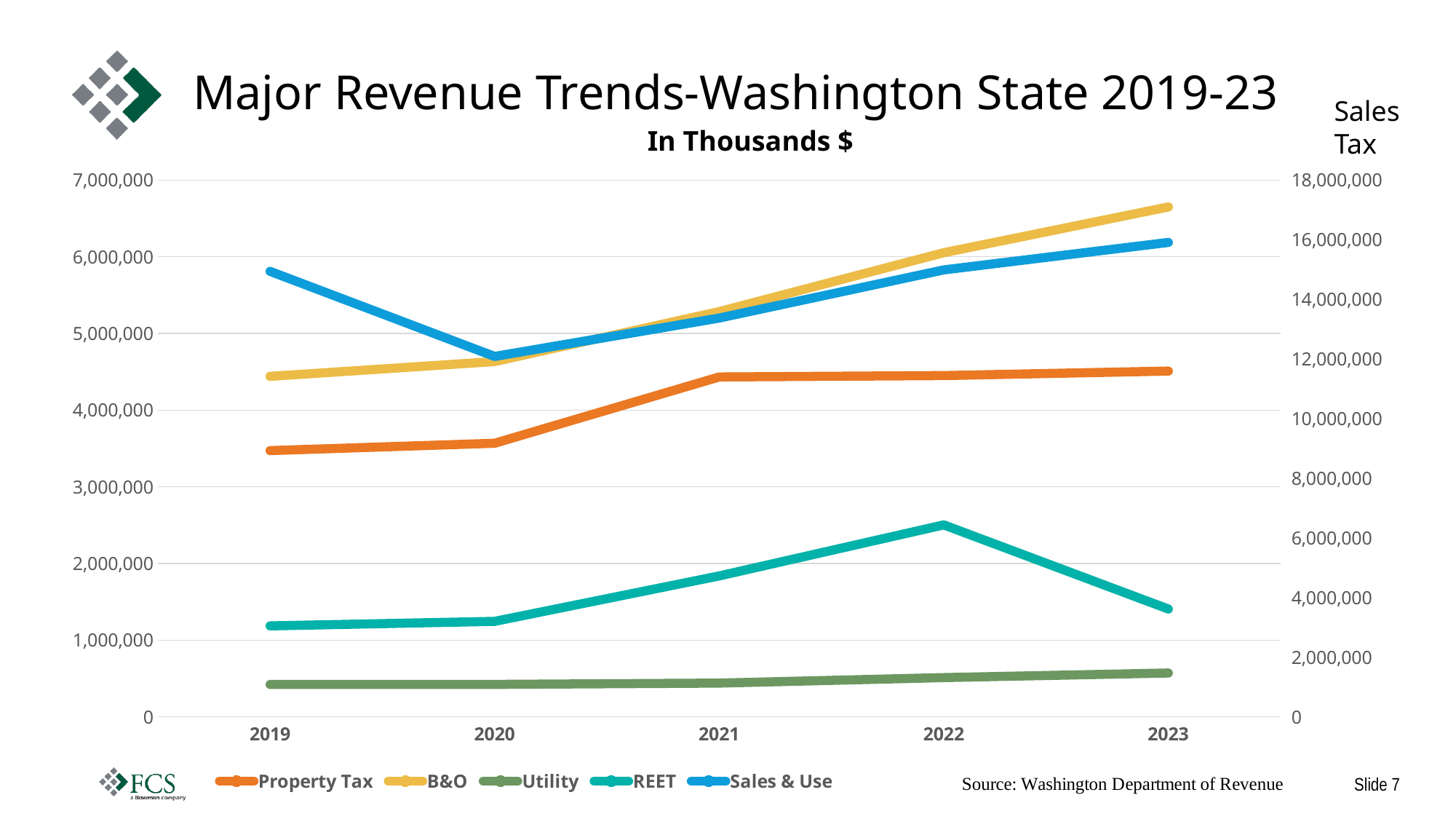
Does the B&O line rise or fall from 2019 to 2023? Rises What is the title of the chart? Major Revenue Trends-Washington State 2019-23 In which year does the REET line reach its highest point? 2022 How many years are plotted along the x axis? 5 How many series does the legend list? 5 Is the Utility value for 2019 greater or less than 1,000,000 on the left axis? less Which series has the lowest values across all years? Utility Is the REET value for 2022 greater or less than 2,000,000 on the left axis? greater What kind of chart is shown on the slide? Line chart What label is shown above the right-hand axis? Sales Tax Which is larger, the REET value in 2022 or in 2023? 2022 Is the B&O value for 2023 greater or less than 6,000,000 on the left axis? greater